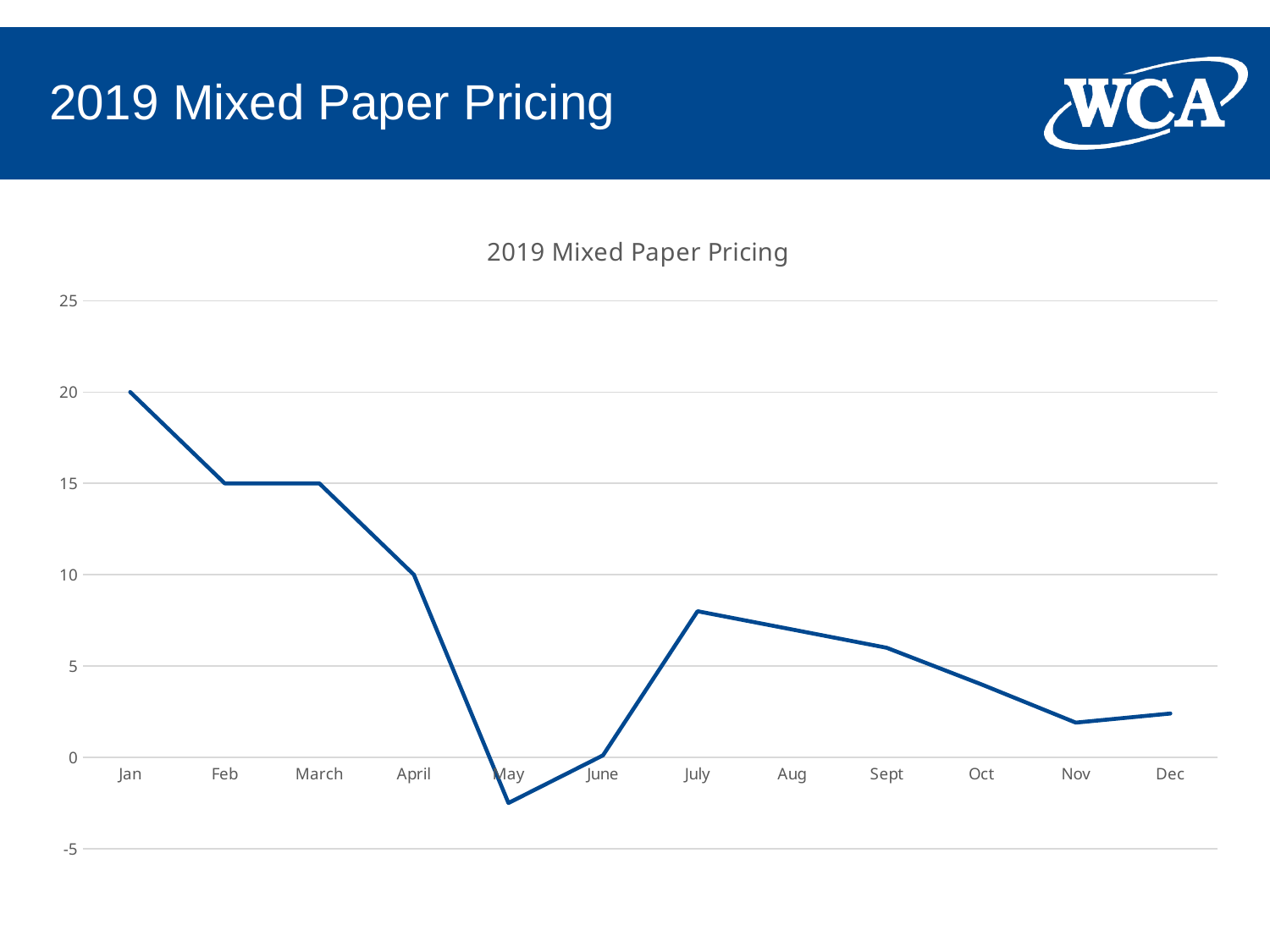
What is the value for Feb? 15 How many months are plotted on the x axis? 12 What is the value for Jan? 20 Which month has the lowest value? May Is the value for May greater or less than 0? less What type of chart is shown on the slide? Line chart What is the value for April? 10 Do the values rise or fall from Jan to May? fall What is the difference between the values for Jan and April? 10 Is the value for July greater or less than 5? greater What is the title of the chart? 2019 Mixed Paper Pricing Which month has the highest value? Jan